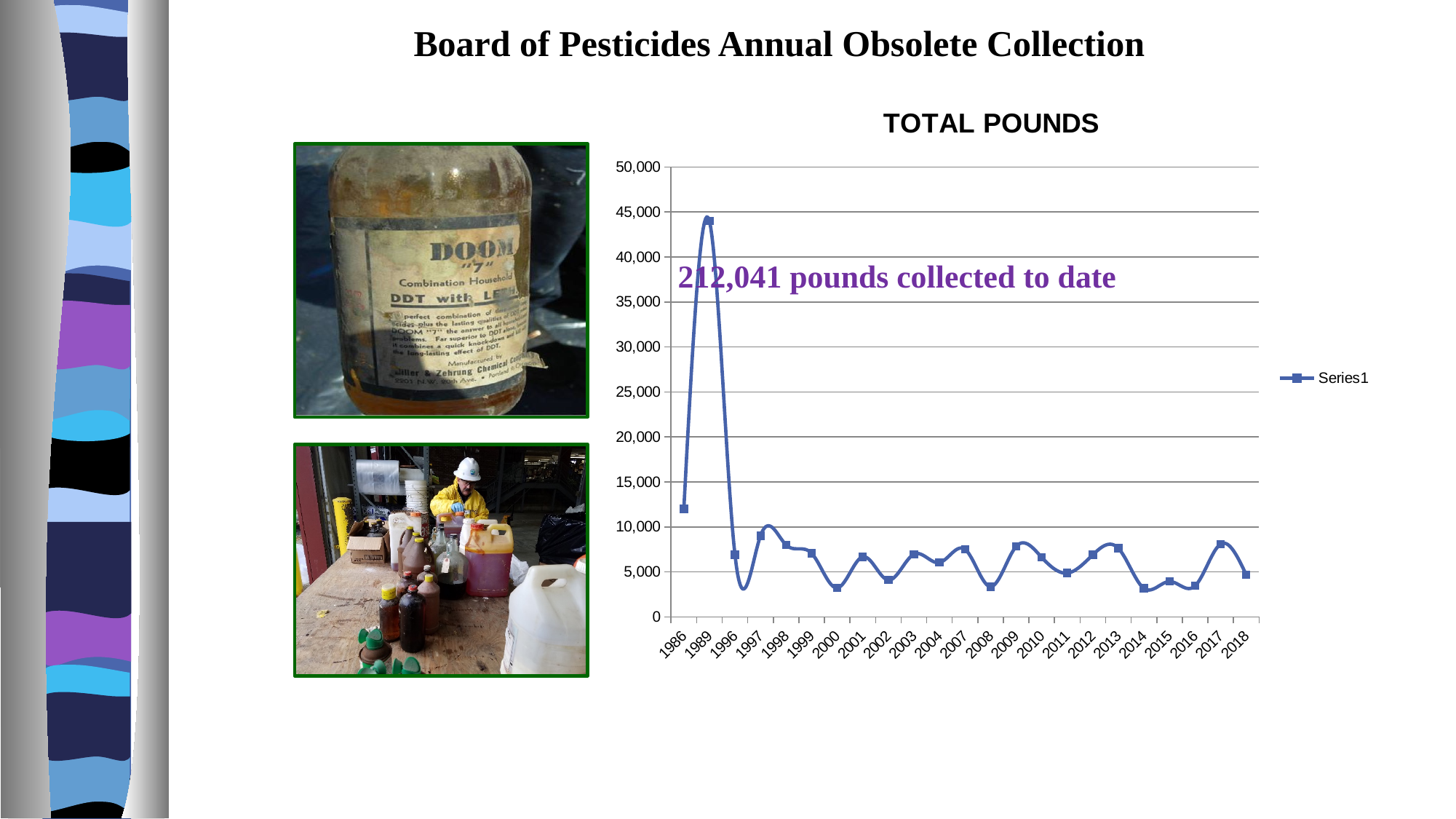
Is the value for 2000 greater or less than 5,000? less Is the value for 2017 greater or less than 5,000? greater Which year has the highest value in the chart? 1989 Is the value for 1989 greater or less than 40,000? greater Does the value rise or fall from 1989 to 1996? fall Which is larger, the value for 2017 or the value for 2014? 2017 How many years are plotted on the x axis of the chart? 23 What is the title of the chart? TOTAL POUNDS How many series does the chart legend list? 1 What kind of chart is shown on the slide? line chart Which is larger, the value for 1986 or the value for 2018? 1986